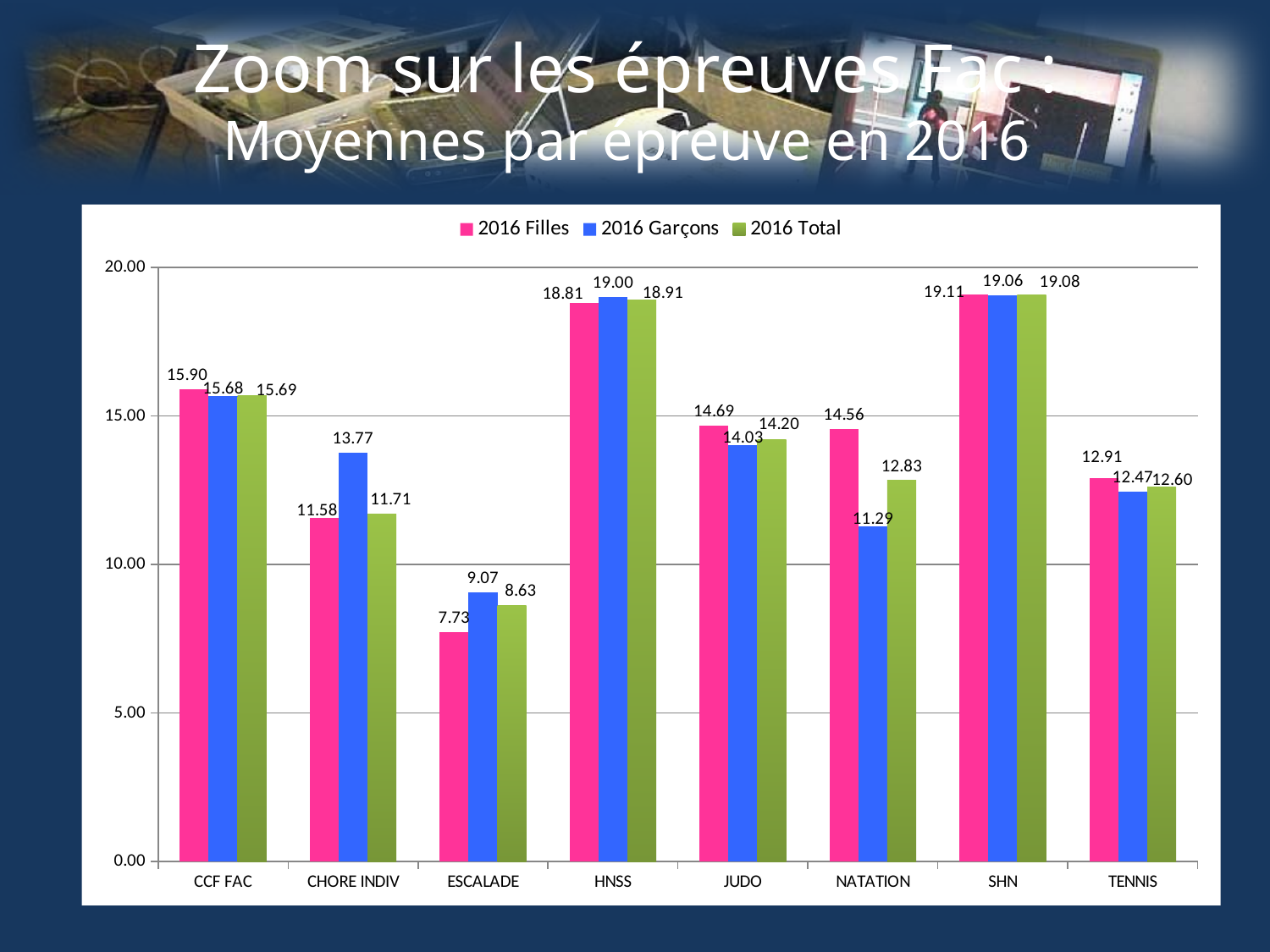
Which is larger for CHORE INDIV: the 2016 Filles value or the 2016 Garçons value? 2016 Garçons What kind of chart is shown on the slide? bar chart Which category has the highest 2016 Filles value? SHN How many categories are shown on the x axis? 8 How many series does the legend list? 3 Is the 2016 Garçons value for ESCALADE greater or less than 10.00? less What is the difference between the 2016 Filles and 2016 Garçons values for NATATION? 3.27 What is the 2016 Filles value for NATATION? 14.56 What is the 2016 Total value for ESCALADE? 8.63 Which category has the lowest 2016 Total value? ESCALADE What is the 2016 Garçons value for CHORE INDIV? 13.77 Which series is shown in blue in the legend? 2016 Garçons